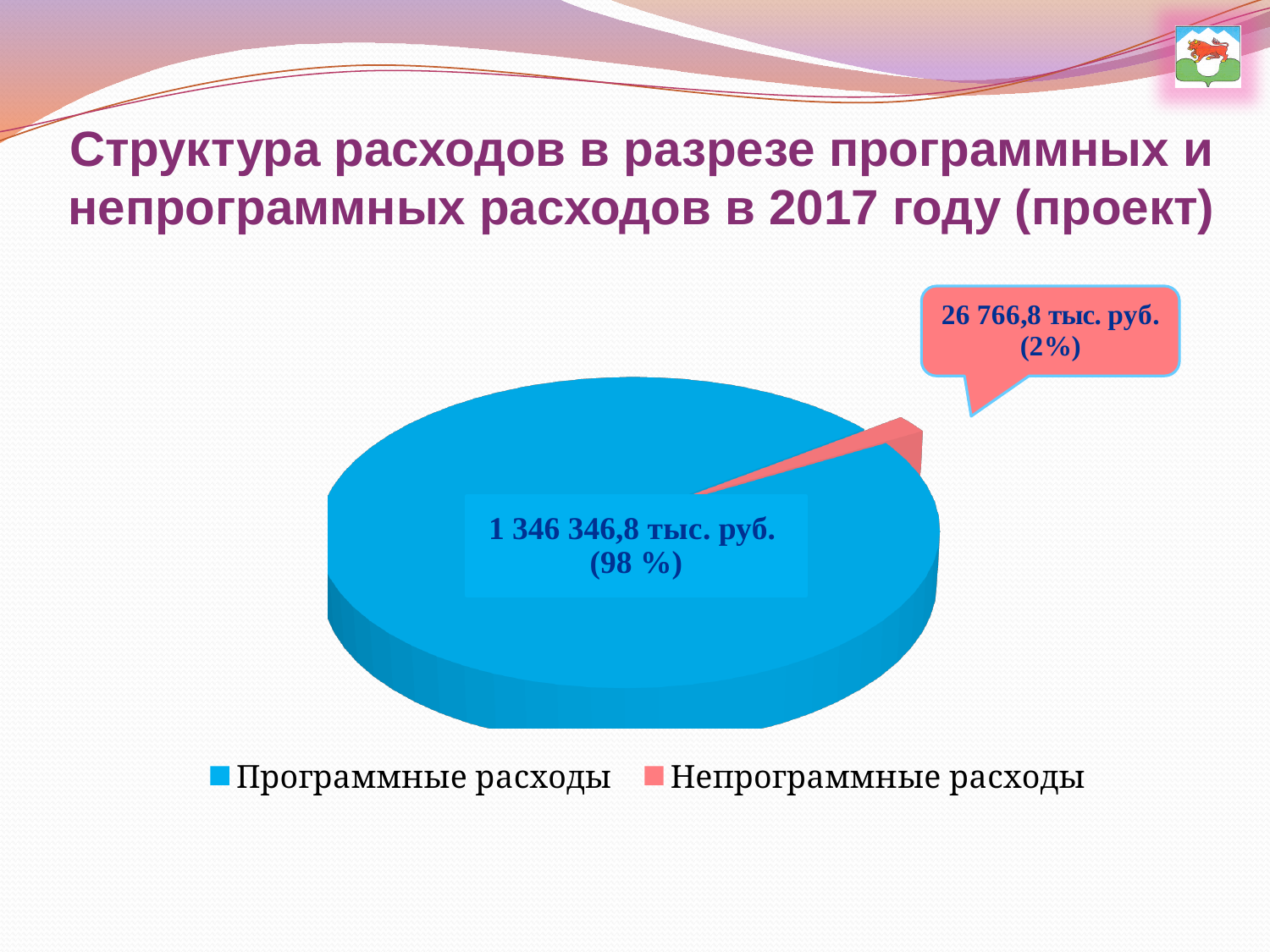
What colour is the slice for Непрограммные расходы? Red (pink) Which category has the largest slice of the pie? Программные расходы Which category has the smallest slice of the pie? Непрограммные расходы Which is larger, Программные расходы or Непрограммные расходы? Программные расходы What is the value for Непрограммные расходы? 26 766,8 тыс. руб. What is the difference between Программные расходы and Непрограммные расходы in тыс. руб.? 1 319 580,0 тыс. руб. What share of the pie does Программные расходы represent? 98 % What is the value for Программные расходы? 1 346 346,8 тыс. руб. How many entries does the legend list? 2 What share of the pie does Непрограммные расходы represent? 2% What type of chart is shown on the slide? Pie chart How many slices does the pie chart have? 2